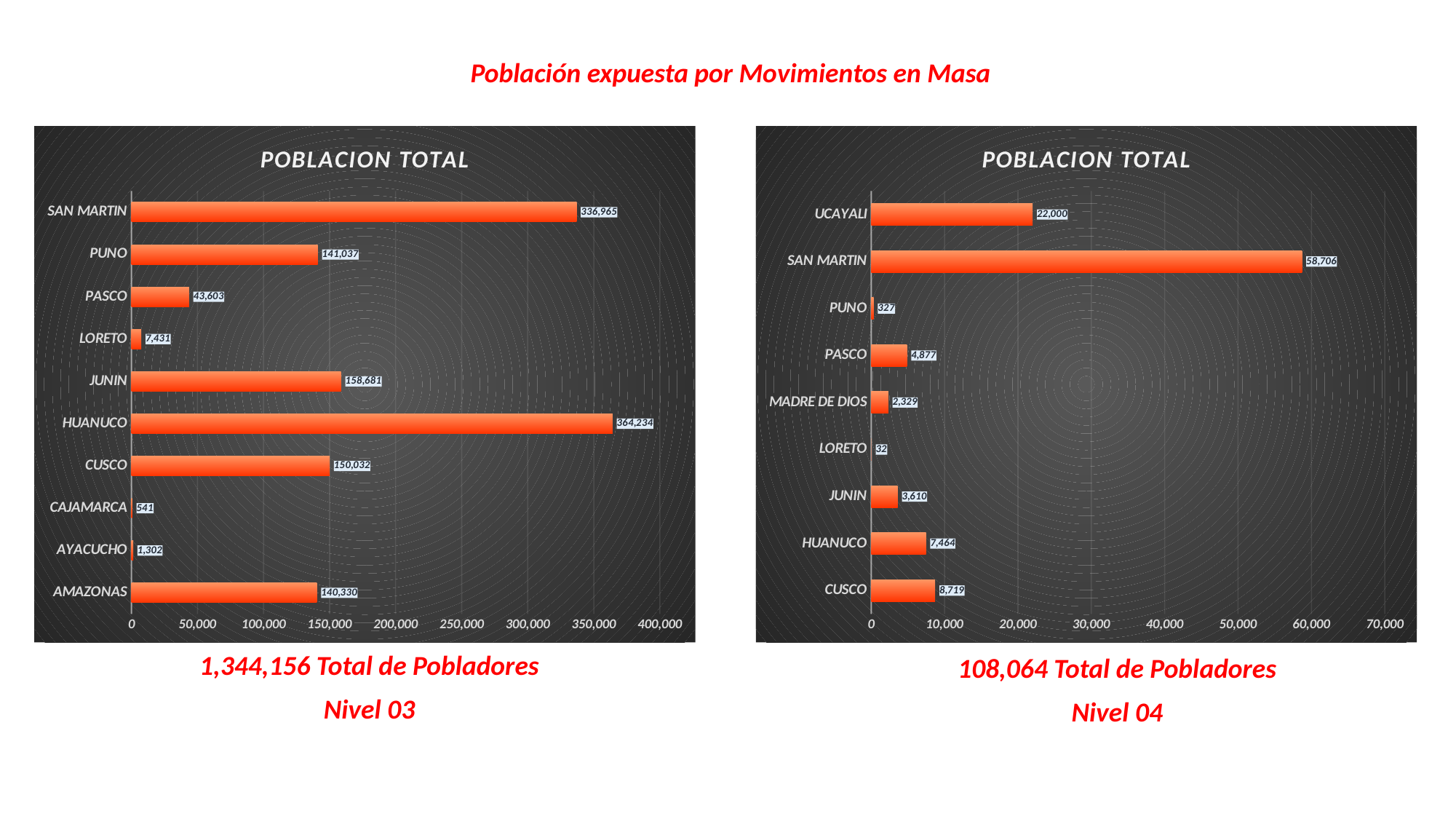
In the right chart (Nivel 04), which is larger, CUSCO or HUANUCO? CUSCO In the left chart (Nivel 03), how many categories are shown? 10 In the right chart (Nivel 04), which category has the lowest value? LORETO In the left chart (Nivel 03), what is the difference between HUANUCO and SAN MARTIN? 27,269 What kind of chart is the right chart (Nivel 04)? Bar chart In the right chart (Nivel 04), what is the difference between SAN MARTIN and UCAYALI? 36,706 In the right chart (Nivel 04), what is the value for SAN MARTIN? 58,706 In the left chart (Nivel 03), which category has the lowest value? CAJAMARCA In the left chart (Nivel 03), which category has the highest value? HUANUCO In the left chart (Nivel 03), what is the value for AMAZONAS? 140,330 In the right chart (Nivel 04), how many categories are shown? 9 In the left chart (Nivel 03), what is the value for HUANUCO? 364,234